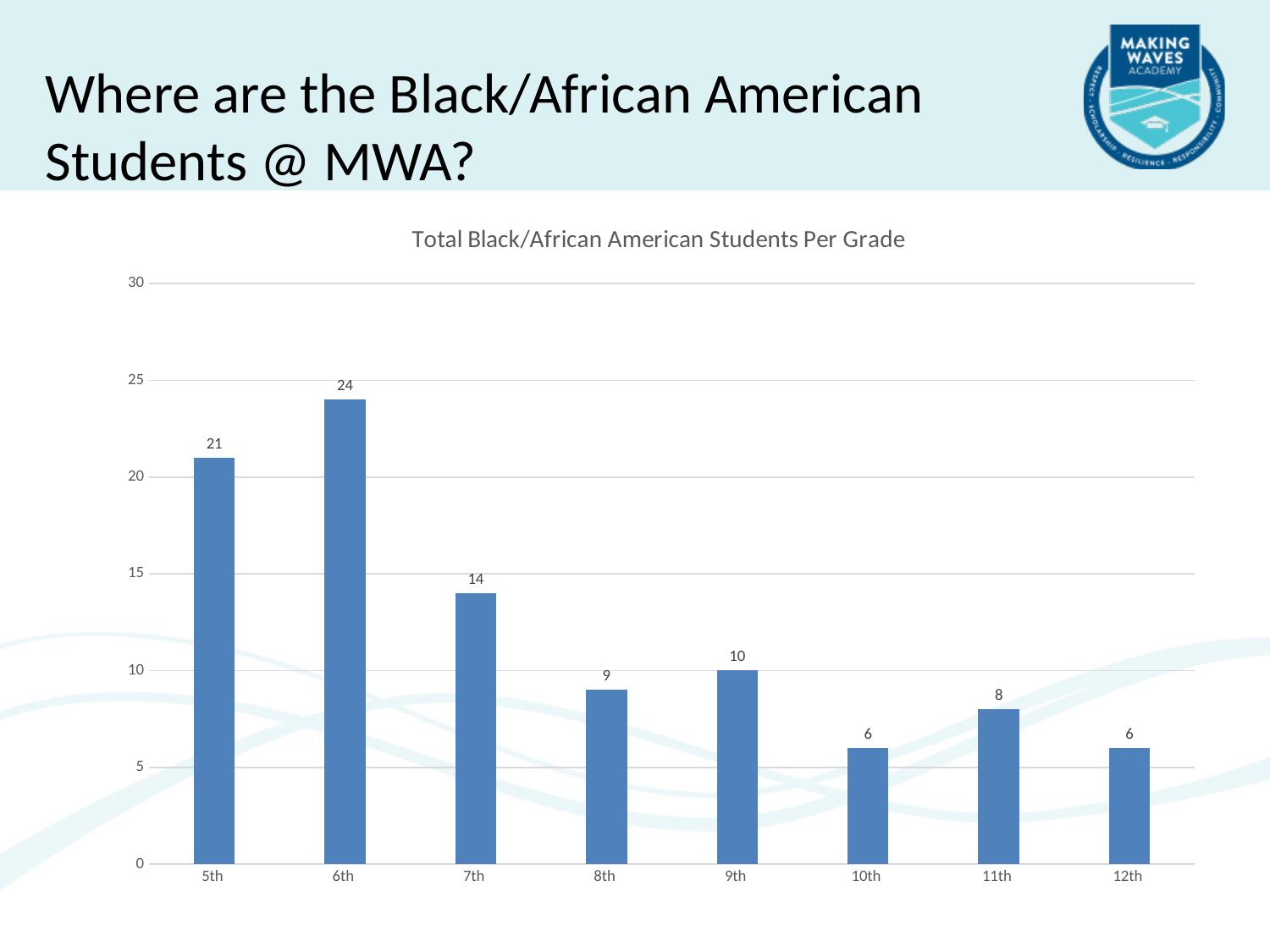
What is the value for 6th grade? 24 Which is larger, the value for 8th grade or the value for 9th grade? 9th What is the value for 9th grade? 10 What kind of chart is shown on the slide? bar chart Which grade has the highest number of Black/African American students? 6th How many grade categories are shown on the chart? 8 What is the value for 11th grade? 8 Which grades have the lowest value on the chart? 10th and 12th What is the title of the chart? Total Black/African American Students Per Grade What is the difference between the values for 5th grade and 7th grade? 7 Is the value for 7th grade greater or less than 15? less What is the difference between the values for 6th grade and 8th grade? 15